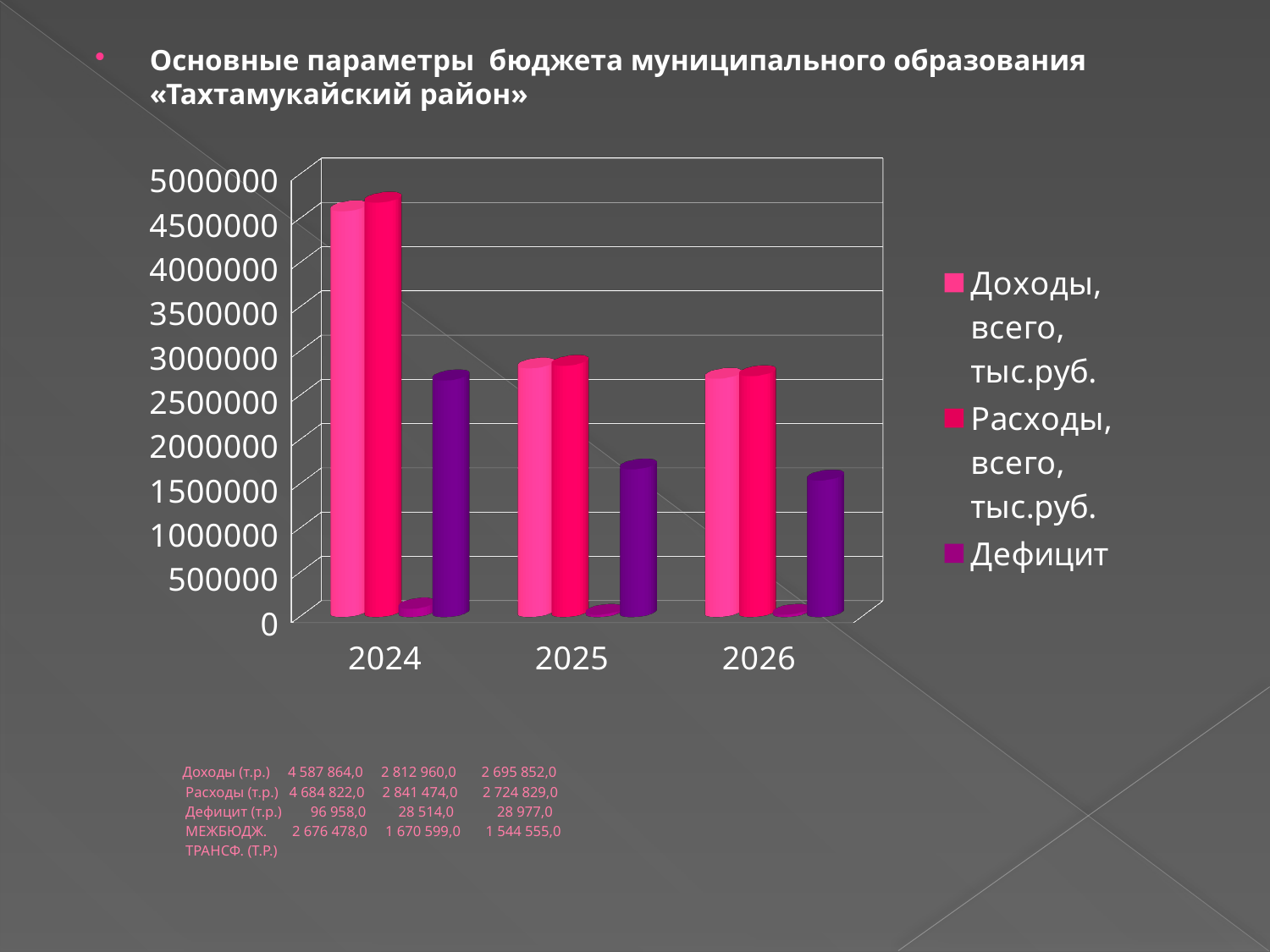
Is the value for Дефицит in 2025 greater or less than 500000? less Is the value for Доходы, всего, тыс.руб. in 2024 greater or less than 4000000? greater Using the values in the table below the chart, what is the difference between Расходы (т.р.) and Доходы (т.р.) in 2024? 96 958,0 What kind of chart is shown on the slide? bar chart How many series does the chart legend list? 3 In 2024, which is larger: Доходы, всего, тыс.руб. or Расходы, всего, тыс.руб.? Расходы, всего, тыс.руб. According to the table below the chart, what is the value of Доходы (т.р.) for 2025? 2 812 960,0 According to the table below the chart, what is the value of Расходы (т.р.) for 2026? 2 724 829,0 Which year has the highest value for Доходы, всего, тыс.руб.? 2024 How many years are shown on the x axis of the chart? 3 Do the values for Доходы, всего, тыс.руб. rise or fall from 2024 to 2026? fall What colour is used for the Дефицит series in the chart legend? purple